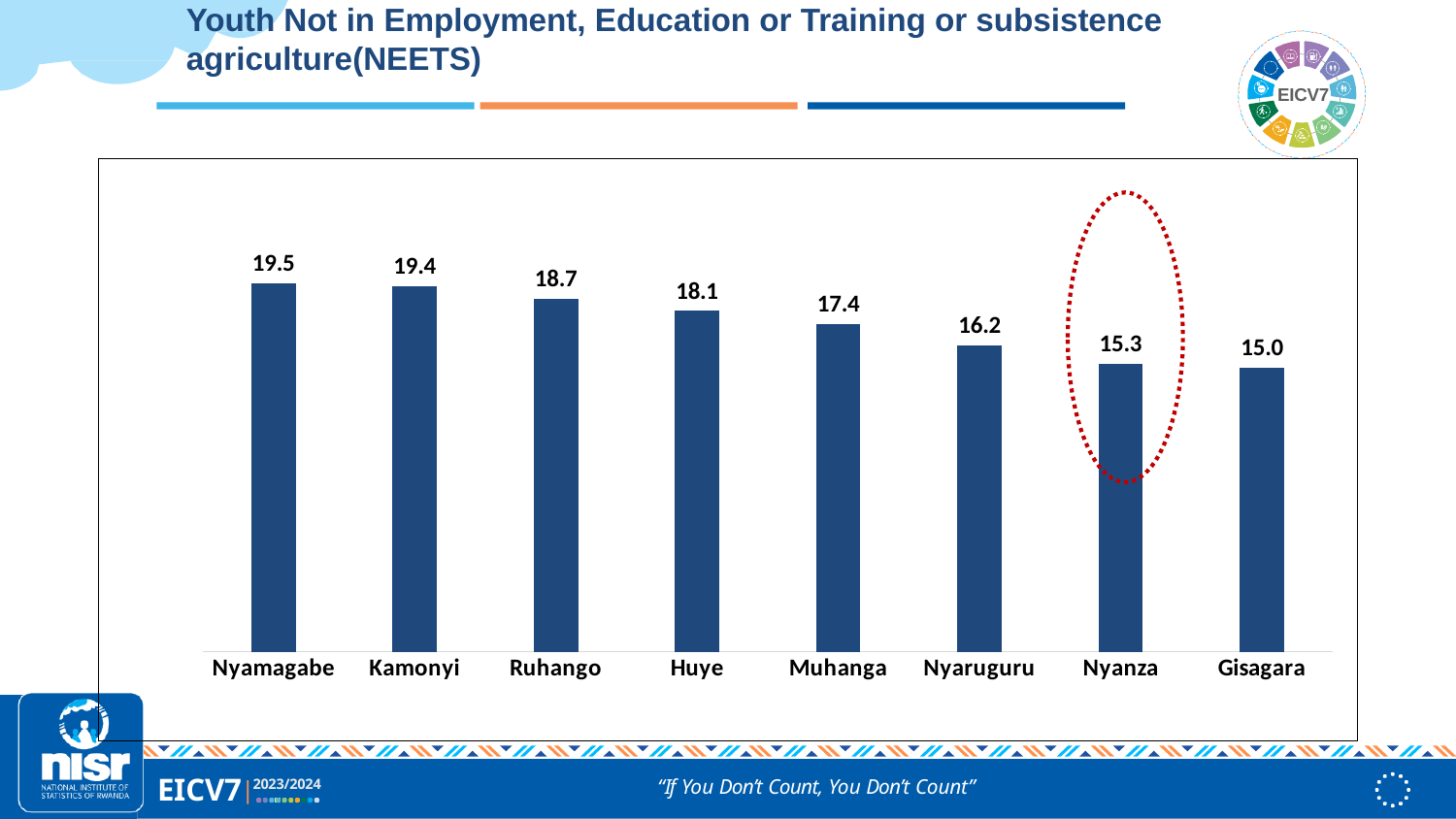
Which district has the lowest value? Gisagara Do the values rise or fall from left to right along the x axis? fall Which is larger, the value for Huye or the value for Nyaruguru? Huye Which district's bar is circled with a red dotted outline? Nyanza What is the value for Nyanza? 15.3 What is the difference between the values for Nyamagabe and Gisagara? 4.5 What is the difference between the values for Ruhango and Nyaruguru? 2.5 How many districts are shown on the chart? 8 What is the value for Muhanga? 17.4 What kind of chart is shown on the slide? bar chart What is the value for Nyamagabe? 19.5 Which district has the highest value? Nyamagabe